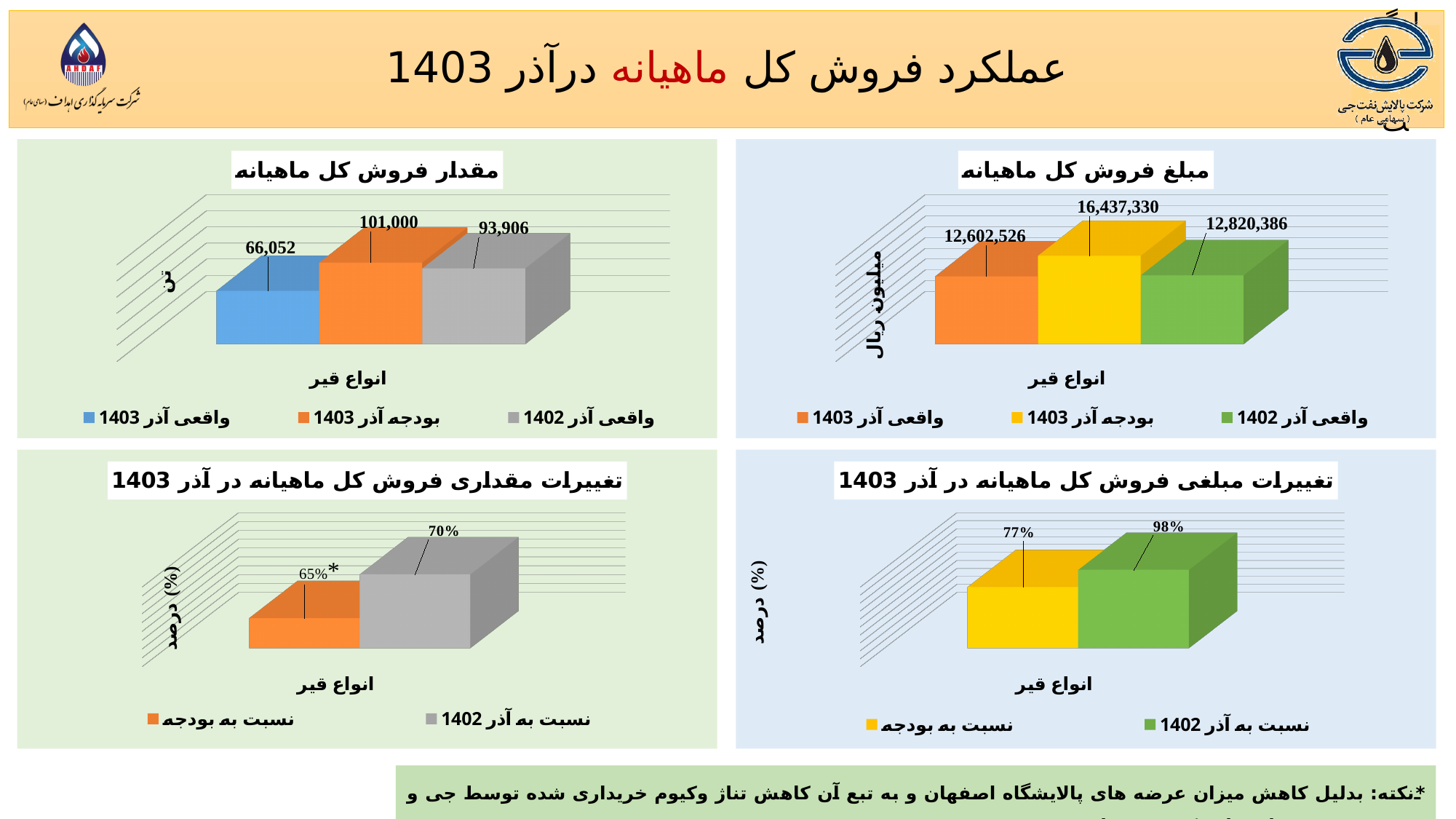
What type of chart is the bottom-left chart titled 'تغییرات مقداری فروش کل ماهیانه در آذر 1403'? bar chart In the top-left chart titled 'مقدار فروش کل ماهیانه', which series has the highest value? بودجه آذر 1403 In the bottom-left chart titled 'تغییرات مقداری فروش کل ماهیانه در آذر 1403', what is the value for 'نسبت به بودجه'? 65% In the top-right chart titled 'مبلغ فروش کل ماهیانه', what is the value for 'بودجه آذر 1403'? 16,437,330 In the top-left chart titled 'مقدار فروش کل ماهیانه', what is the value for 'واقعی آذر 1403'? 66,052 In the top-left chart titled 'مقدار فروش کل ماهیانه', what is the difference between 'بودجه آذر 1403' and 'واقعی آذر 1403'? 34,948 In the top-right chart titled 'مبلغ فروش کل ماهیانه', which series has the lowest value? واقعی آذر 1403 In the bottom-right chart titled 'تغییرات مبلغی فروش کل ماهیانه در آذر 1403', which is larger: 'نسبت به بودجه' or 'نسبت به آذر 1402'? نسبت به آذر 1402 How many series does the legend of the top-right chart titled 'مبلغ فروش کل ماهیانه' list? 3 In the bottom-right chart titled 'تغییرات مبلغی فروش کل ماهیانه در آذر 1403', what is the value for 'نسبت به آذر 1402'? 98% In the top-left chart titled 'مقدار فروش کل ماهیانه', what is the value for 'بودجه آذر 1403'? 101,000 In the top-right chart titled 'مبلغ فروش کل ماهیانه', what is the difference between 'واقعی آذر 1402' and 'واقعی آذر 1403'? 217,860